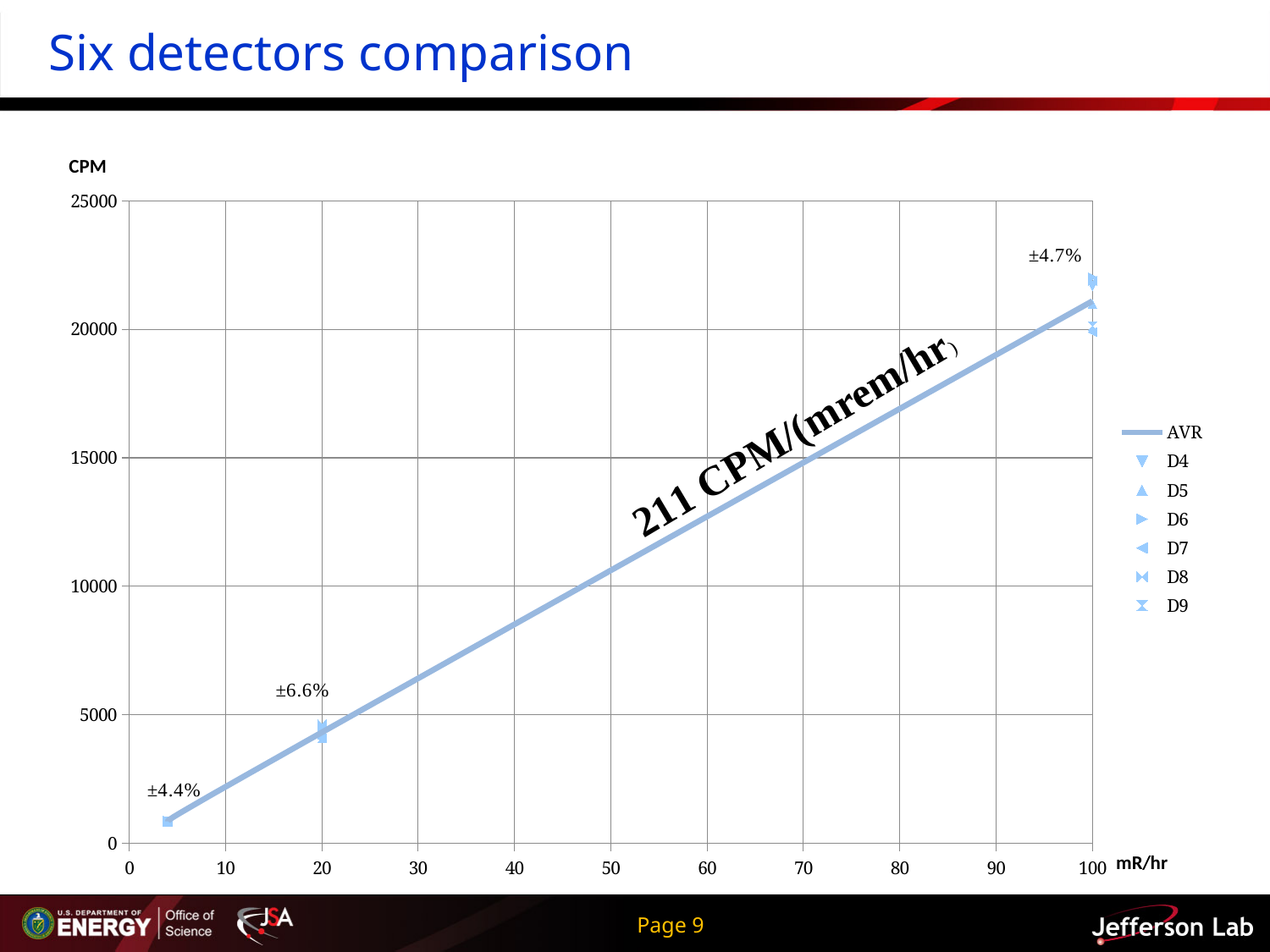
Do the CPM values rise or fall as mR/hr increases along the x axis? Rise What kind of chart is shown on the slide? Line chart with scatter markers What uncertainty percentage is printed next to the data points at 100 mR/hr? ±4.7% What uncertainty percentage is printed next to the data points at 20 mR/hr? ±6.6% What uncertainty percentage is printed next to the lowest data points near 4 mR/hr? ±4.4% What slope is printed along the AVR line? 211 CPM/(mrem/hr) Is the AVR value at 20 mR/hr greater or less than 5000 CPM? less What is the label of the x axis? mR/hr Is the AVR value at 100 mR/hr greater or less than 20000 CPM? greater Is the AVR value at 50 mR/hr greater or less than 15000 CPM? less How many series does the chart legend list? 7 What is the title of the chart slide? Six detectors comparison